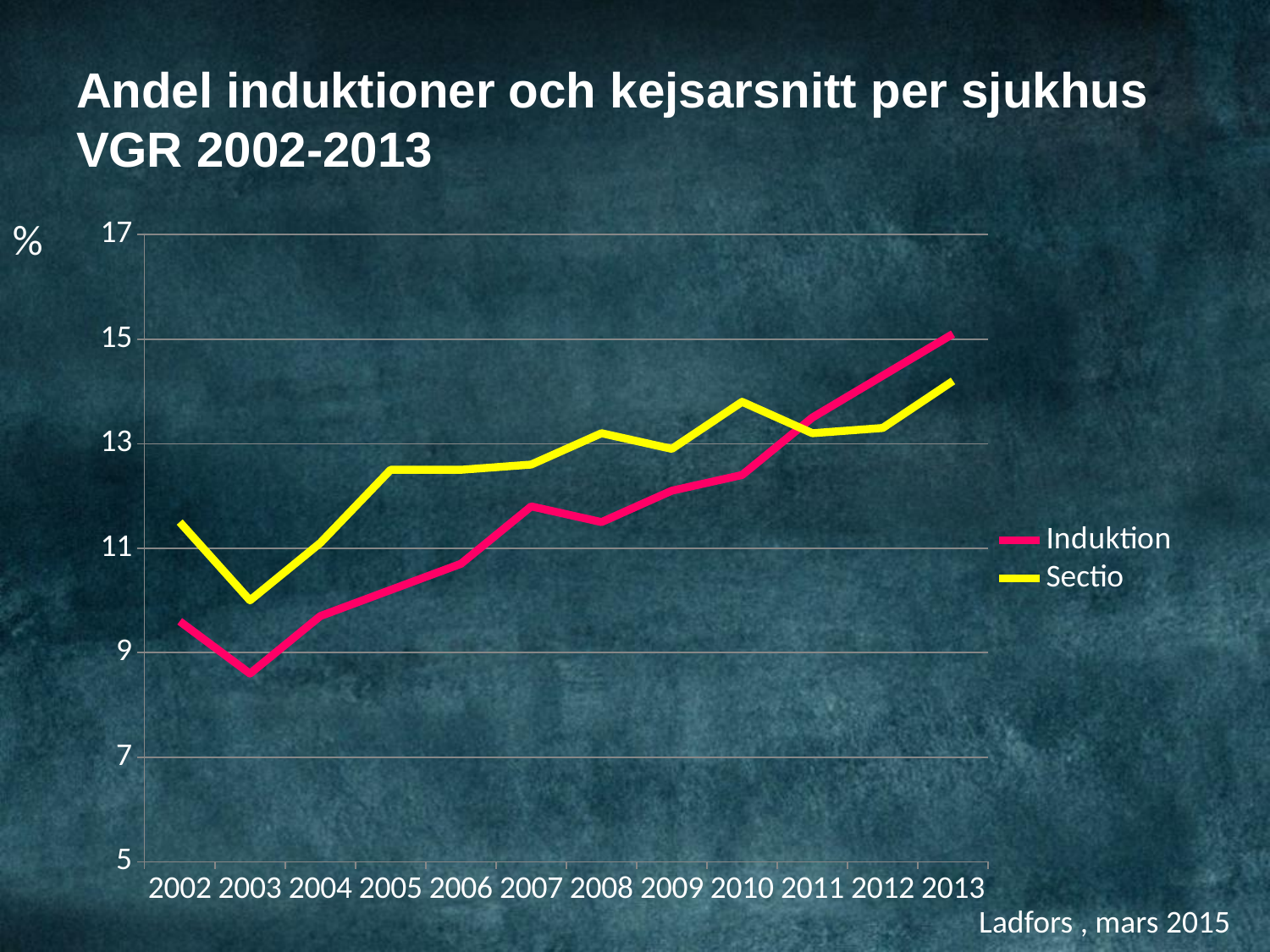
How many years are plotted along the x axis? 12 How many series does the legend list? 2 Is the Sectio value for 2010 greater or less than 13? greater In which year is the Induktion series at its highest? 2013 Is the Induktion value for 2003 greater or less than 9? less In which year is the Sectio series at its lowest? 2003 In 2002, which series has the higher value, Induktion or Sectio? Sectio What kind of chart is shown on the slide? line chart Is the Induktion value for 2013 greater or less than 13? greater What unit is shown on the y axis of the chart? % Does the Induktion series generally rise or fall from 2003 to 2013? rise In which year is the Induktion series at its lowest? 2003